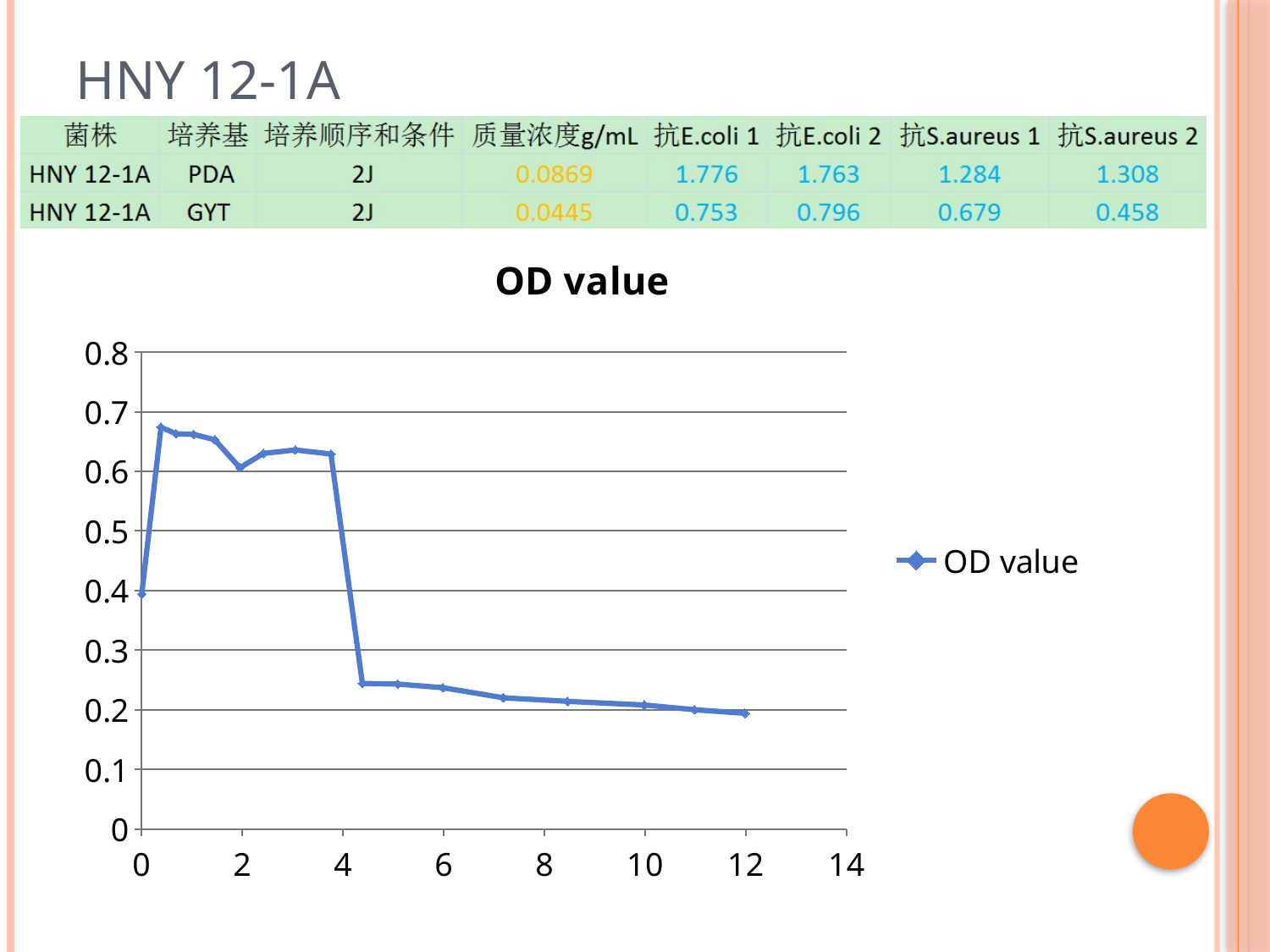
Which is larger, the OD value at x = 2 or the OD value at x = 6? x = 2 What is the name of the series shown in the chart legend? OD value Is the OD value at x = 3 greater or less than 0.6? greater Is the OD value at x = 0 greater or less than 0.5? less What kind of chart is shown on the slide? line chart What is the title of the chart? OD value Is the OD value at x = 10 greater or less than 0.3? less How many series does the chart legend list? 1 Between x = 4 and x = 12, does the OD value generally rise or fall? fall What is the highest value shown on the y axis of the chart? 0.8